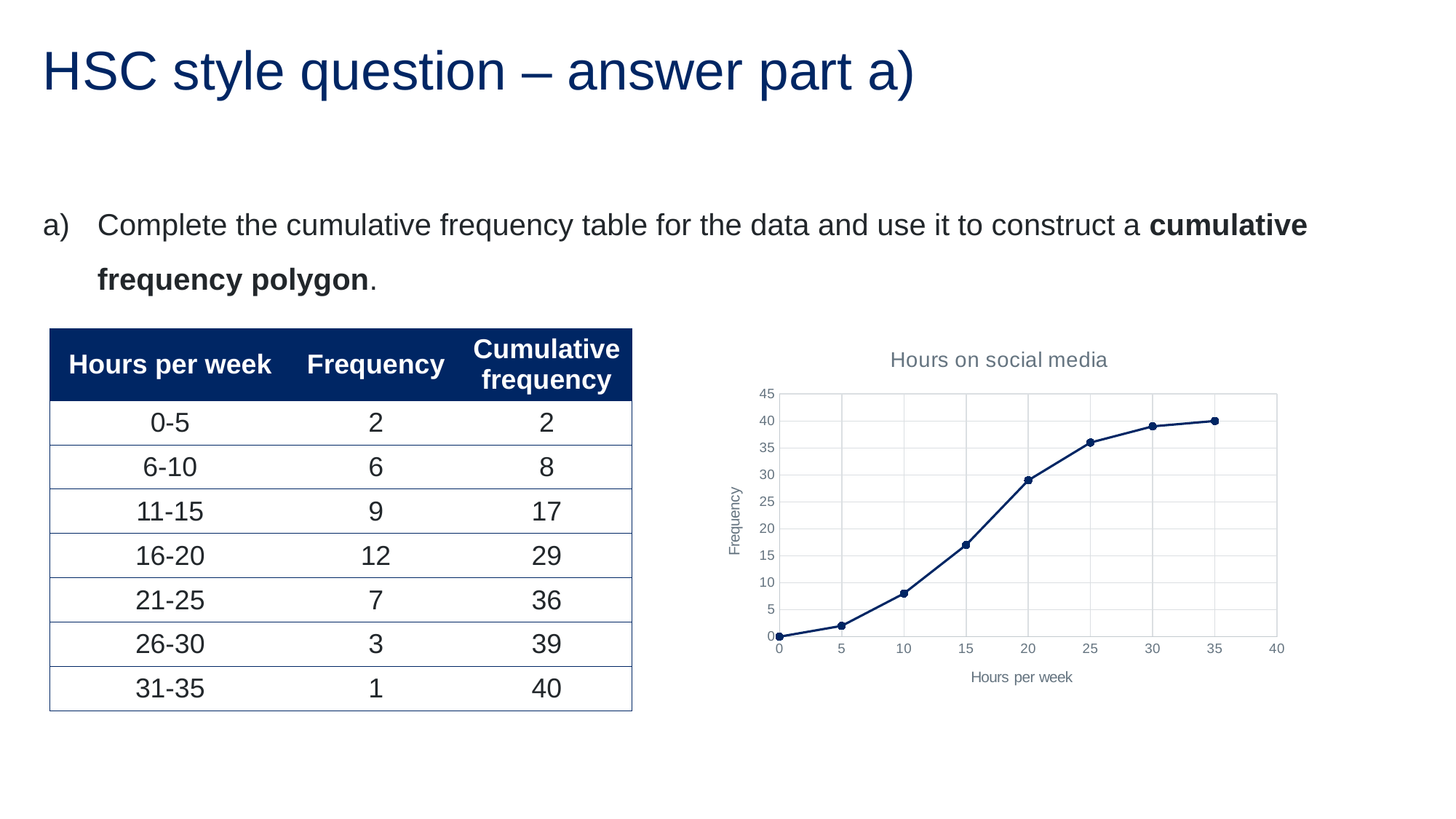
Is the value plotted at 10 hours per week greater or less than 10? less Which is larger: the value plotted at 15 hours per week or at 25 hours per week? 25 hours per week At which hours-per-week value is the plotted cumulative frequency highest? 35 Is the value plotted at 20 hours per week greater or less than 25? greater Is the value plotted at 25 hours per week greater or less than 35? greater What kind of chart is shown on the slide? line chart How many data points are plotted on the chart? 8 What is the value plotted at 0 hours per week? 0 What is the title of the chart? Hours on social media Do the plotted values rise or fall as hours per week increase? rise What is the cumulative frequency plotted at 35 hours per week? 40 What is the label on the horizontal axis of the chart? Hours per week